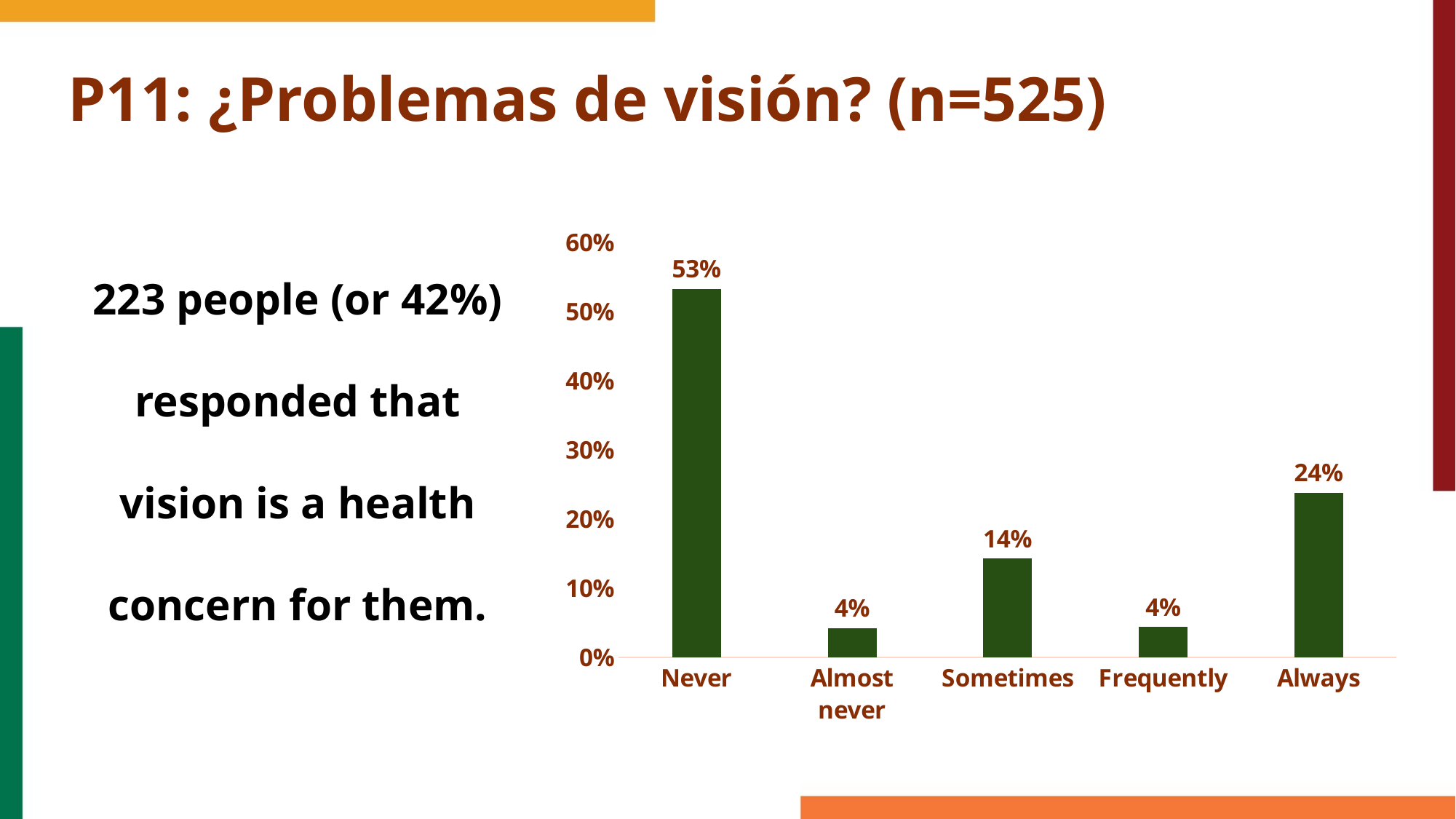
How many categories are shown on the x axis? 5 What kind of chart is shown on the slide? bar chart Which category has the highest value? Never What is the difference between the values for Never and Always? 29% Is the value for Never greater or less than 50%? greater What is the highest value shown on the y axis? 60% What is the value for Never? 53% What is the difference between the values for Sometimes and Frequently? 10% Which is larger, the value for Sometimes or the value for Always? Always What is the value for Sometimes? 14% What is the value for Almost never? 4% What is the value for Always? 24%